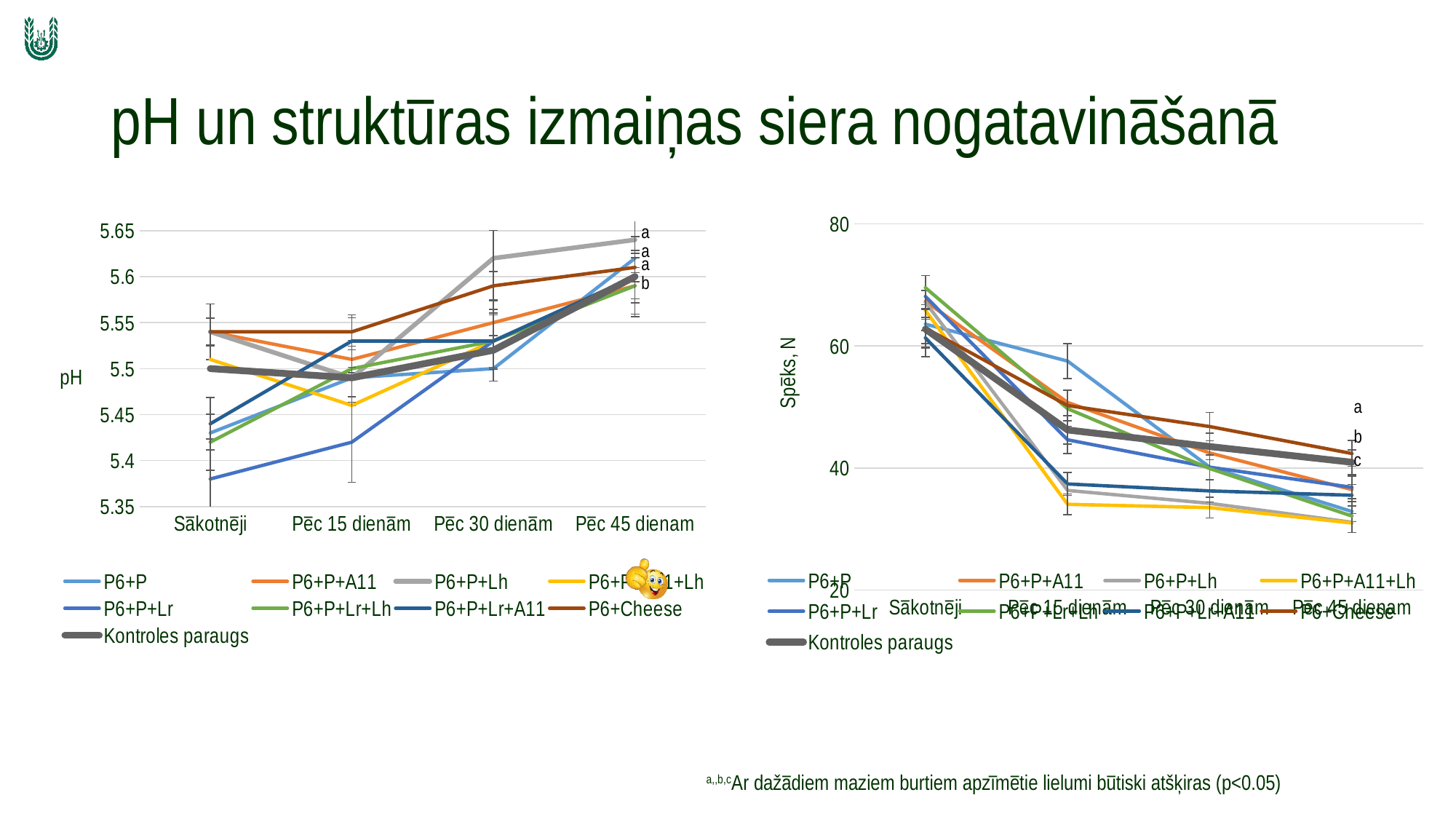
In the left pH chart, is the value for P6+Cheese at Sākotnēji greater or less than 5.5? greater How many categories are shown on the x axis of the right chart (Spēks, N)? 4 How many series does the legend of the left pH chart list? 9 In the left pH chart, which series has the lowest value at Sākotnēji? P6+P+Lr In the right chart (Spēks, N), is the value for P6+P at Pēc 15 dienām greater or less than 40? greater In the right chart (Spēks, N), is the value for P6+P+A11+Lh at Pēc 45 dienam greater or less than 40? less In the right chart (Spēks, N), do the values generally rise or fall from Sākotnēji to Pēc 45 dienam? fall What kind of chart is the pH chart on the left of the slide? line chart What is the y-axis label of the right chart? Spēks, N In the left pH chart, which series has the highest value at Pēc 45 dienam? P6+P+Lh In the left pH chart, do the values generally rise or fall from Sākotnēji to Pēc 45 dienam? rise